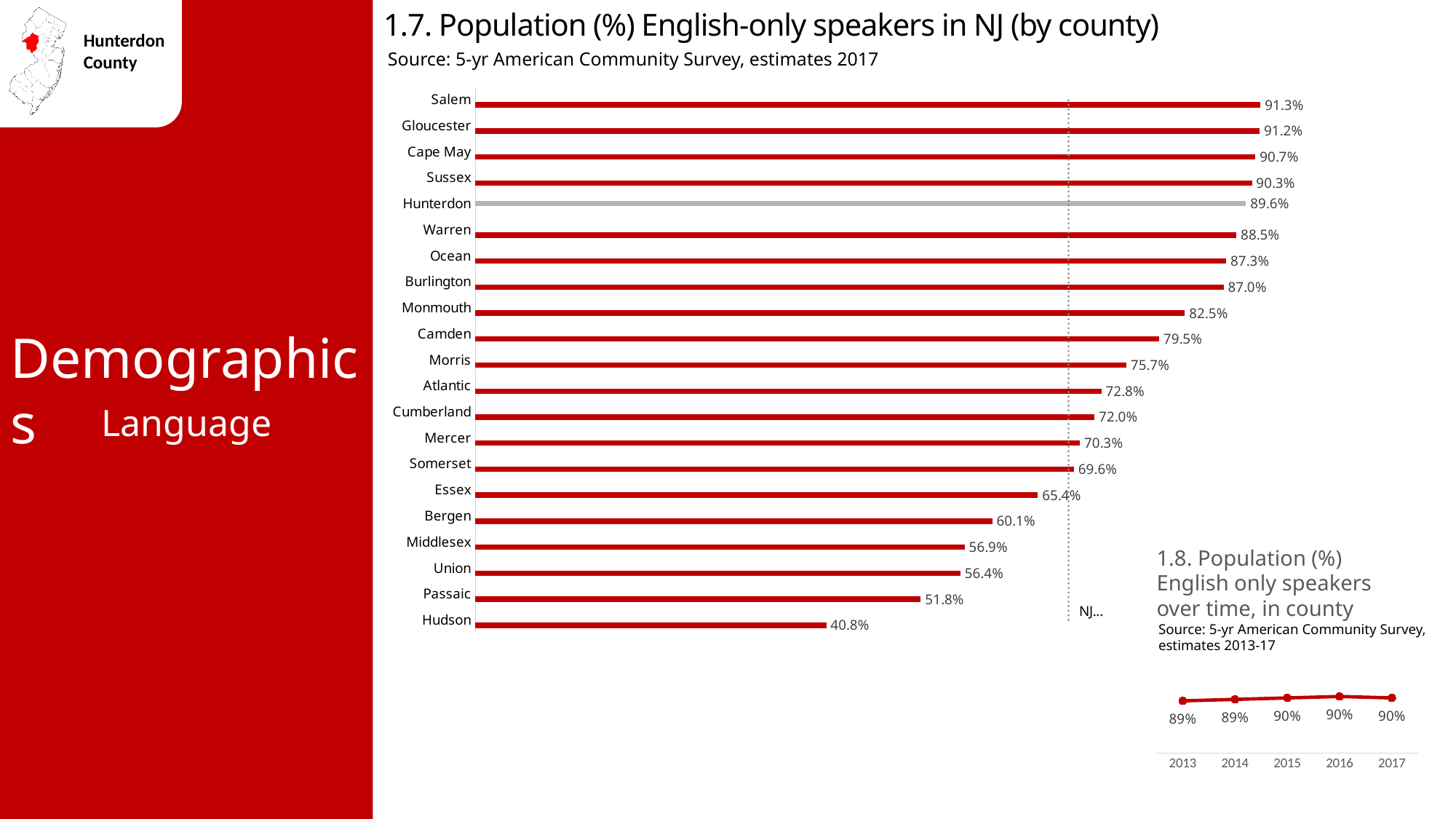
In the chart '1.8. Population (%) English only speakers over time, in county', how many years are plotted? 5 In the chart '1.7. Population (%) English-only speakers in NJ (by county)', which county has the lowest value? Hudson In the chart '1.7. Population (%) English-only speakers in NJ (by county)', which county has the highest value? Salem In the chart '1.7. Population (%) English-only speakers in NJ (by county)', how many counties are shown? 21 In the chart '1.7. Population (%) English-only speakers in NJ (by county)', what is the value for Hudson? 40.8% In the chart '1.7. Population (%) English-only speakers in NJ (by county)', what is the value for Hunterdon? 89.6% In the chart '1.7. Population (%) English-only speakers in NJ (by county)', which county's bar is coloured grey instead of red? Hunterdon What kind of chart is '1.7. Population (%) English-only speakers in NJ (by county)'? Bar chart In the chart '1.7. Population (%) English-only speakers in NJ (by county)', what is the difference between Salem and Hudson? 50.5% In the chart '1.8. Population (%) English only speakers over time, in county', what is the value for 2013? 89% In the chart '1.7. Population (%) English-only speakers in NJ (by county)', what is the value for Passaic? 51.8% In the chart '1.7. Population (%) English-only speakers in NJ (by county)', which is larger, Bergen or Essex? Essex